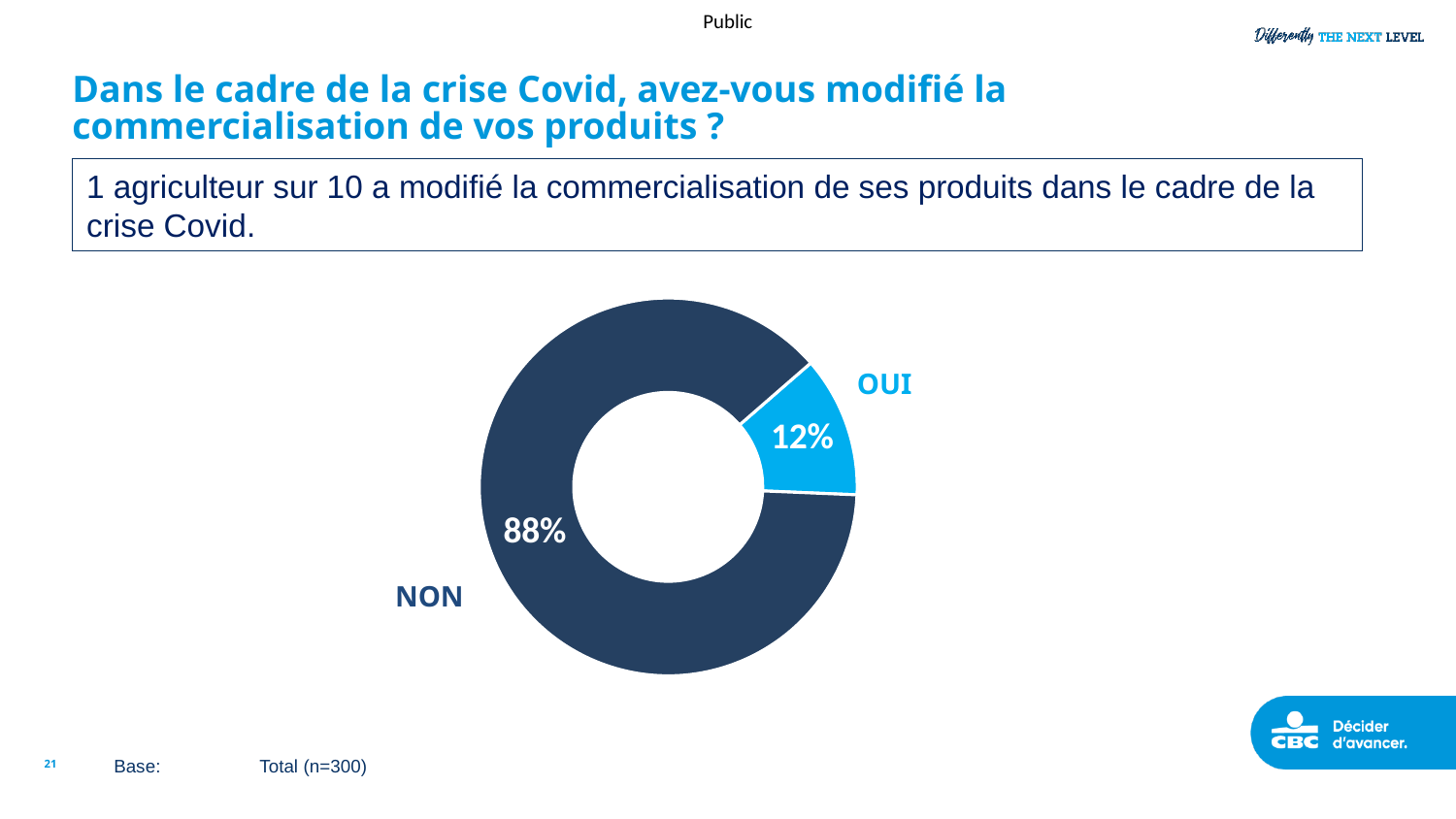
Which category has the largest share of the chart? NON How many categories are shown in the chart? 2 What is the base (sample size) indicated for the chart? Total (n=300) Which category has the smallest share of the chart? OUI What kind of chart is shown on the slide? Doughnut (pie) chart What percentage of respondents answered OUI? 12% What percentage of respondents answered NON? 88% Which is larger, the share for OUI or the share for NON? NON What colour is the OUI slice? Light blue What is the difference in percentage points between NON and OUI? 76 What share of the chart does the OUI slice represent? 12%